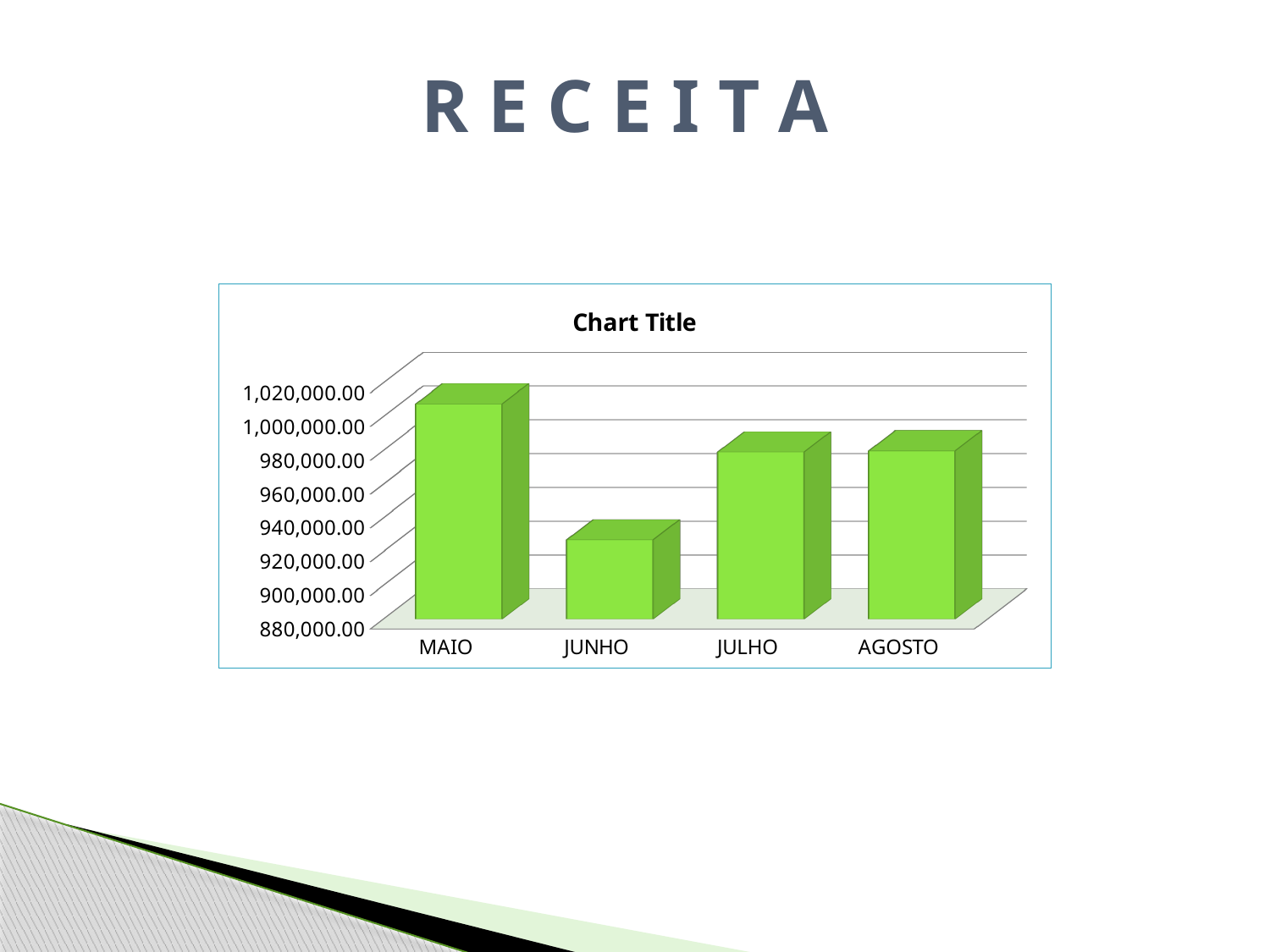
Is the value for MAIO greater or less than 980,000.00? greater Which is larger, the value for JUNHO or the value for JULHO? JULHO How many categories are shown on the x axis of the chart? 4 Which category has the lowest value in the chart? JUNHO What kind of chart is shown on the slide? Bar chart Is the value for JUNHO greater or less than 960,000.00? less What colour are the bars in the chart? Green Is the value for JULHO greater or less than 940,000.00? greater Which category has the highest value in the chart? MAIO Which is larger, the value for MAIO or the value for JUNHO? MAIO What is the title shown above the chart? Chart Title